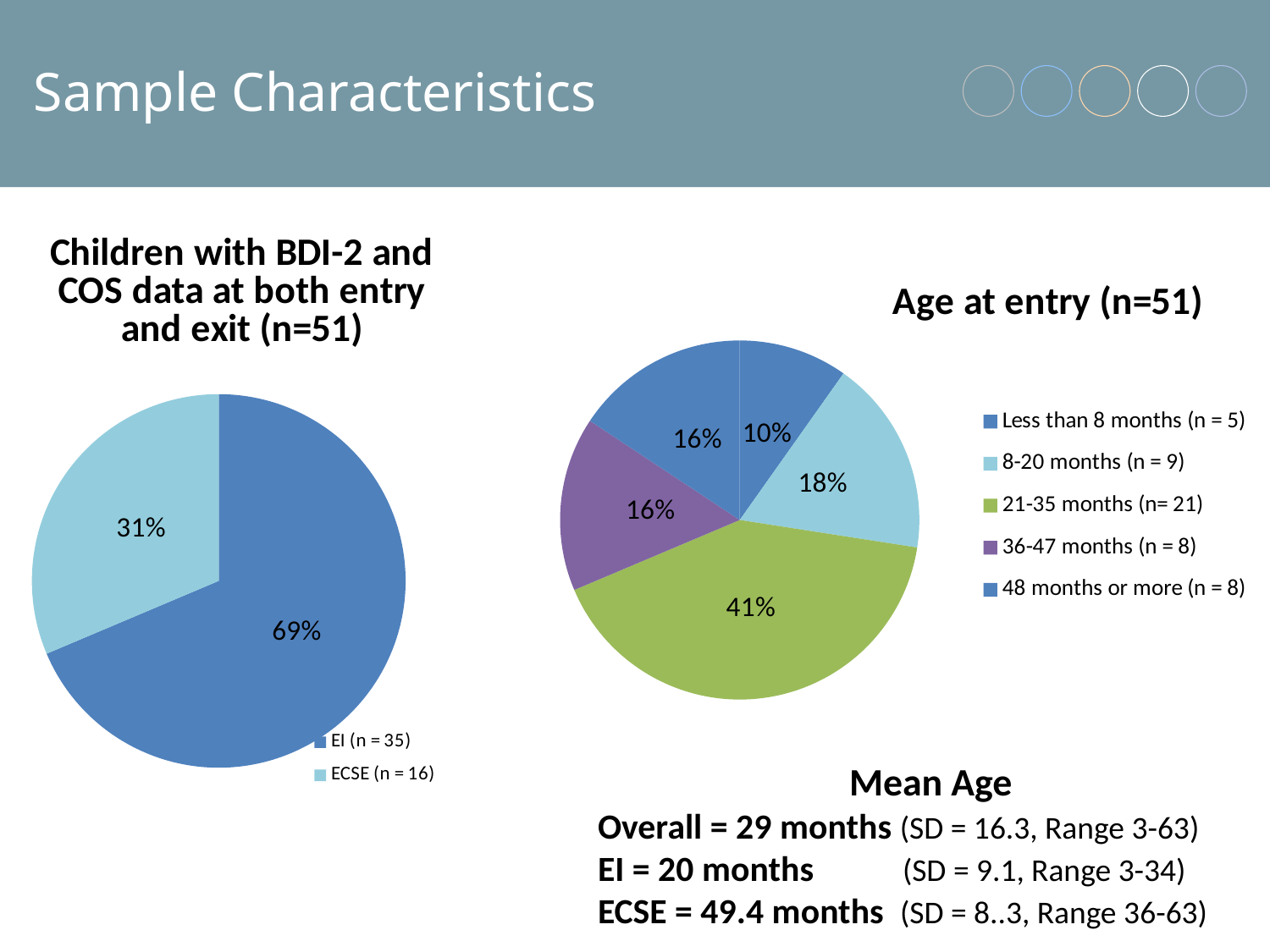
In the 'Children with BDI-2 and COS data at both entry and exit (n=51)' chart, what sample size does the legend give for EI? n = 35 In the 'Age at entry (n=51)' pie chart, which age group has the largest slice? 21-35 months In the 'Age at entry (n=51)' pie chart, what is the difference in percentage points between the 21-35 months slice and the 8-20 months slice? 23 percentage points In the 'Age at entry (n=51)' pie chart, which age group has the smallest slice? Less than 8 months What kind of chart is the 'Children with BDI-2 and COS data at both entry and exit (n=51)' chart? Pie chart In the 'Age at entry (n=51)' pie chart, what percentage is shown for the 8-20 months slice? 18% In the 'Children with BDI-2 and COS data at both entry and exit (n=51)' chart, what percentage is shown for EI? 69% In the 'Children with BDI-2 and COS data at both entry and exit (n=51)' chart, which group is larger, EI or ECSE? EI In the 'Age at entry (n=51)' pie chart, what share of the pie is the 21-35 months slice? 41% In the 'Age at entry (n=51)' pie chart, what percentage is shown for the 'Less than 8 months' slice? 10% In the 'Age at entry (n=51)' pie chart, how many age groups does the legend list? 5 In the 'Children with BDI-2 and COS data at both entry and exit (n=51)' chart, what share of the pie is ECSE? 31%